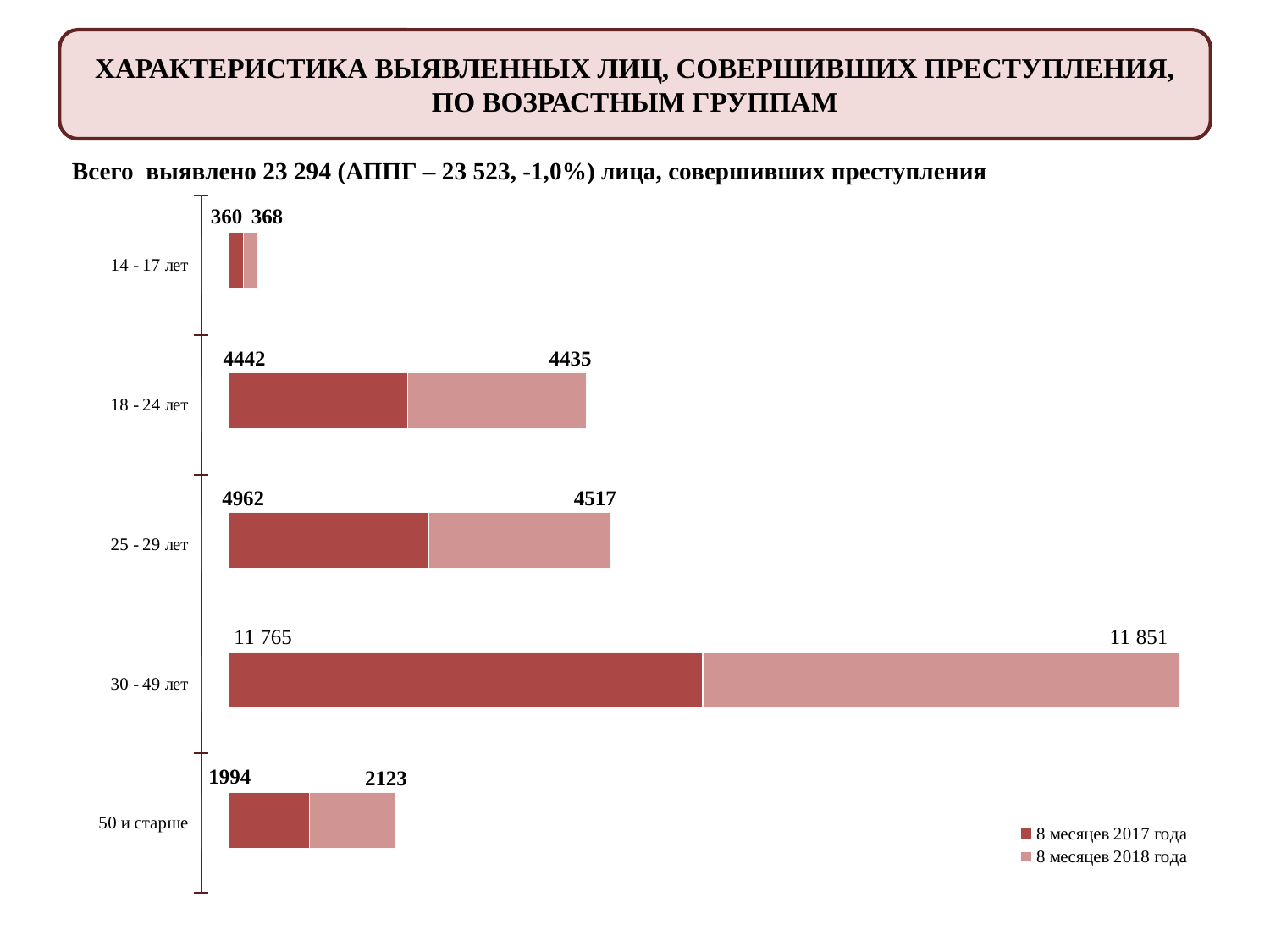
What kind of chart is shown on the slide? Stacked bar chart What is the difference between the 8 месяцев 2017 года and 8 месяцев 2018 года values for the 25 - 29 лет age group? 445 What is the value for the 30 - 49 лет age group in the 8 месяцев 2017 года series? 11 765 How many series does the legend list? 2 What is the value for the 14 - 17 лет age group in the 8 месяцев 2017 года series? 360 How many age groups are shown on the chart? 5 For the 50 и старше age group, which series has the larger value: 8 месяцев 2017 года or 8 месяцев 2018 года? 8 месяцев 2018 года Which age group has the lowest value in the 8 месяцев 2017 года series? 14 - 17 лет What is the value for the 50 и старше age group in the 8 месяцев 2018 года series? 2123 Which series is shown in the darker red colour? 8 месяцев 2017 года What is the total of the stacked bar for the 18 - 24 лет age group? 8877 Which age group has the highest value in the 8 месяцев 2018 года series? 30 - 49 лет